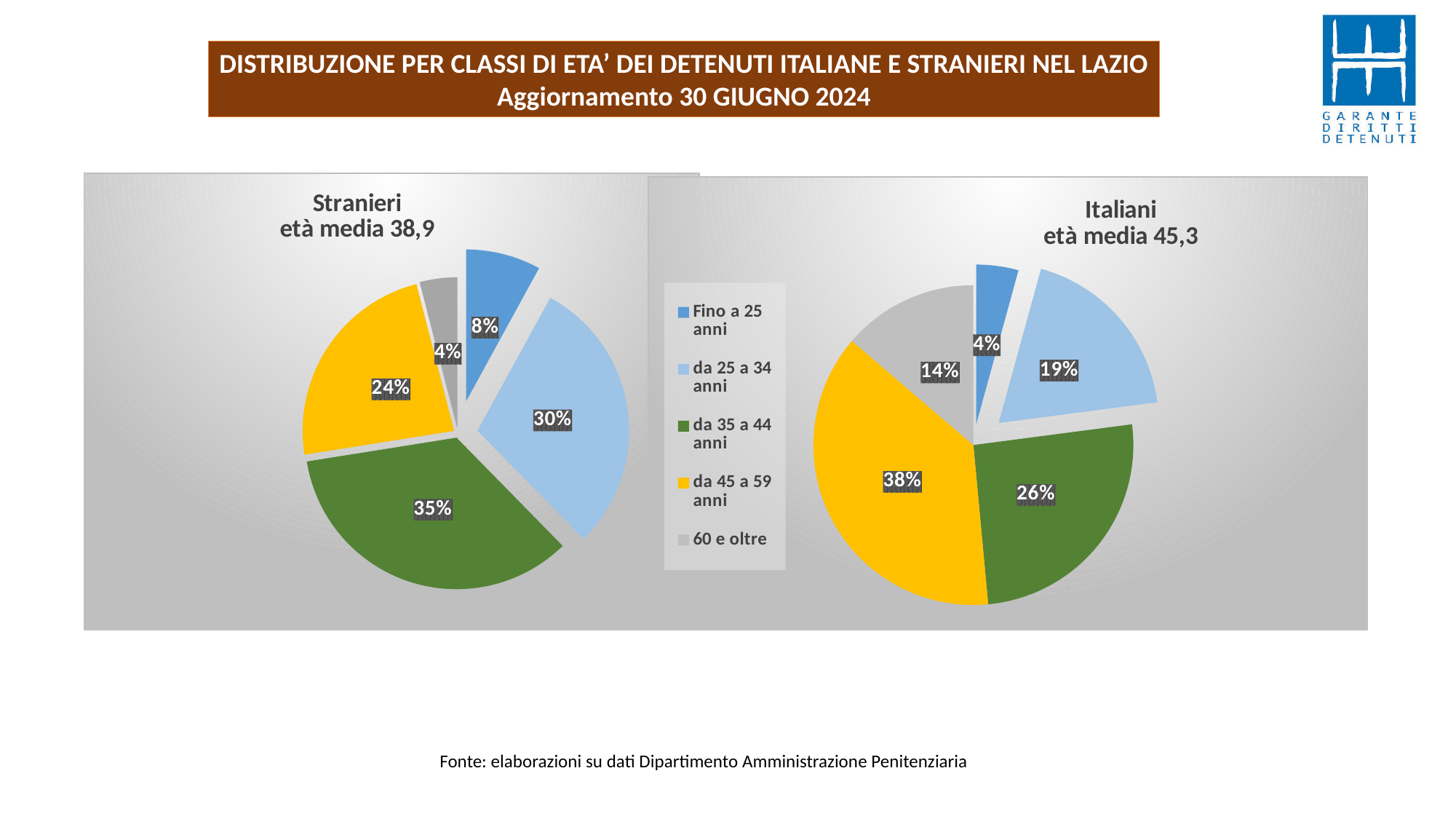
In the 'Italiani' pie chart, which age class has the smallest share? Fino a 25 anni What kind of chart is used for the 'Stranieri' data? Pie chart Which colour represents 'da 45 a 59 anni' in the legend? Yellow In the 'Stranieri' pie chart, which age class has the largest share? da 35 a 44 anni In the 'Stranieri' pie chart, what share is shown for '60 e oltre'? 4% How many age classes does the legend list? 5 What average age (età media) is shown in the title of the 'Italiani' chart? 45,3 In the 'Stranieri' pie chart, what share is shown for 'da 35 a 44 anni'? 35% In the 'Italiani' pie chart, what is the difference between the shares for 'da 45 a 59 anni' and 'da 35 a 44 anni'? 12% In the 'Italiani' pie chart, what share is shown for 'Fino a 25 anni'? 4% Which chart shows a larger share for 'da 25 a 34 anni', 'Stranieri' or 'Italiani'? Stranieri In the 'Italiani' pie chart, what share is shown for 'da 45 a 59 anni'? 38%